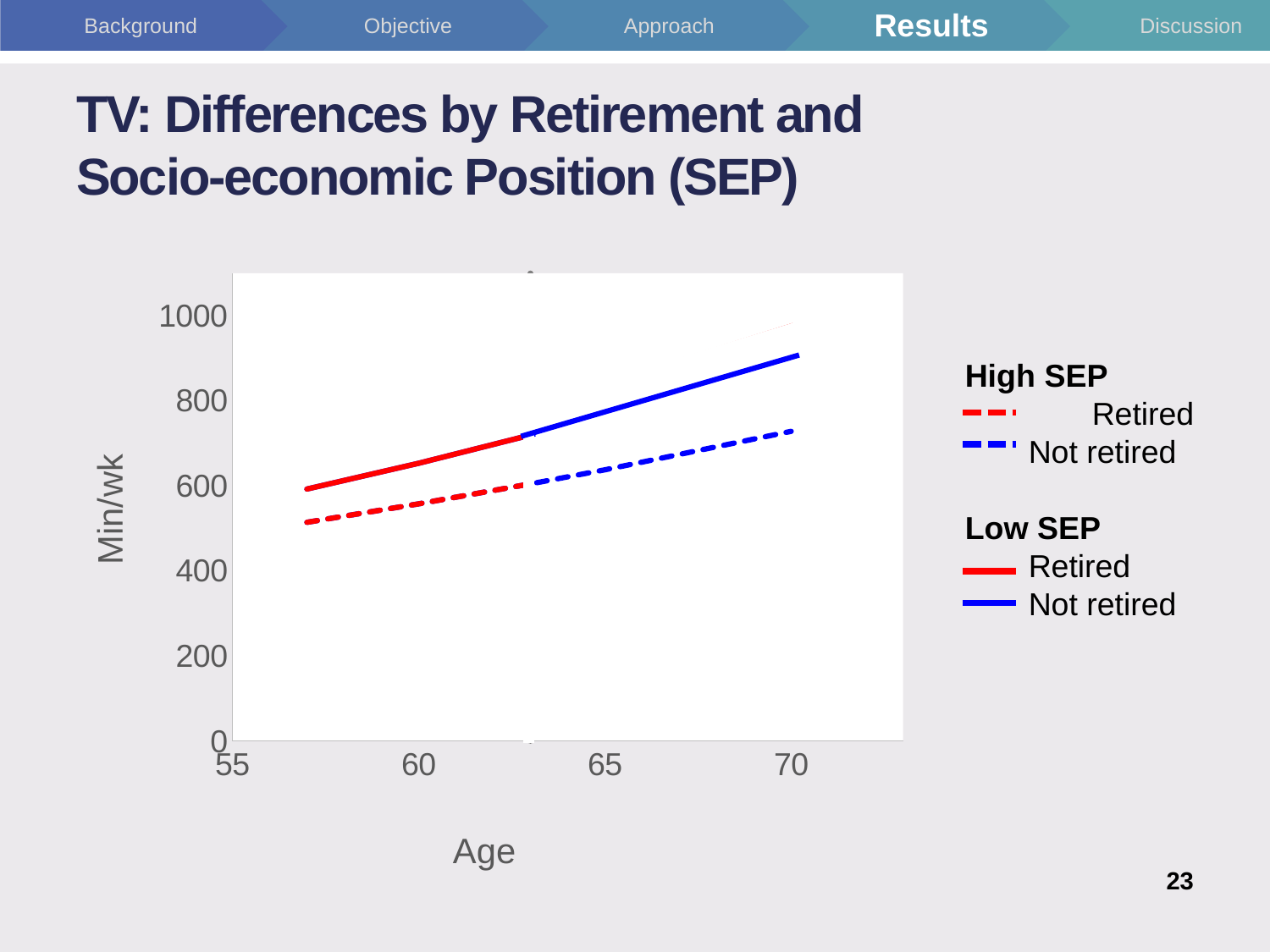
What kind of chart is shown on the slide? line chart At age 70, which is larger: the value for Low SEP Not retired or the value for High SEP Not retired? Low SEP Not retired Is the value for High SEP Not retired at age 70 greater or less than 800? less Is the value for High SEP Retired at age 60 greater or less than 600? less At age 60, which is larger: the value for Low SEP Retired or the value for High SEP Retired? Low SEP Retired Is the value for Low SEP Not retired at age 70 greater or less than 800? greater What is the label of the y axis? Min/wk Do the values for the High SEP Retired line rise or fall as age increases? rise What is the label of the x axis? Age How many series does the legend list? 4 Do the values for the Low SEP Not retired line rise or fall as age increases? rise